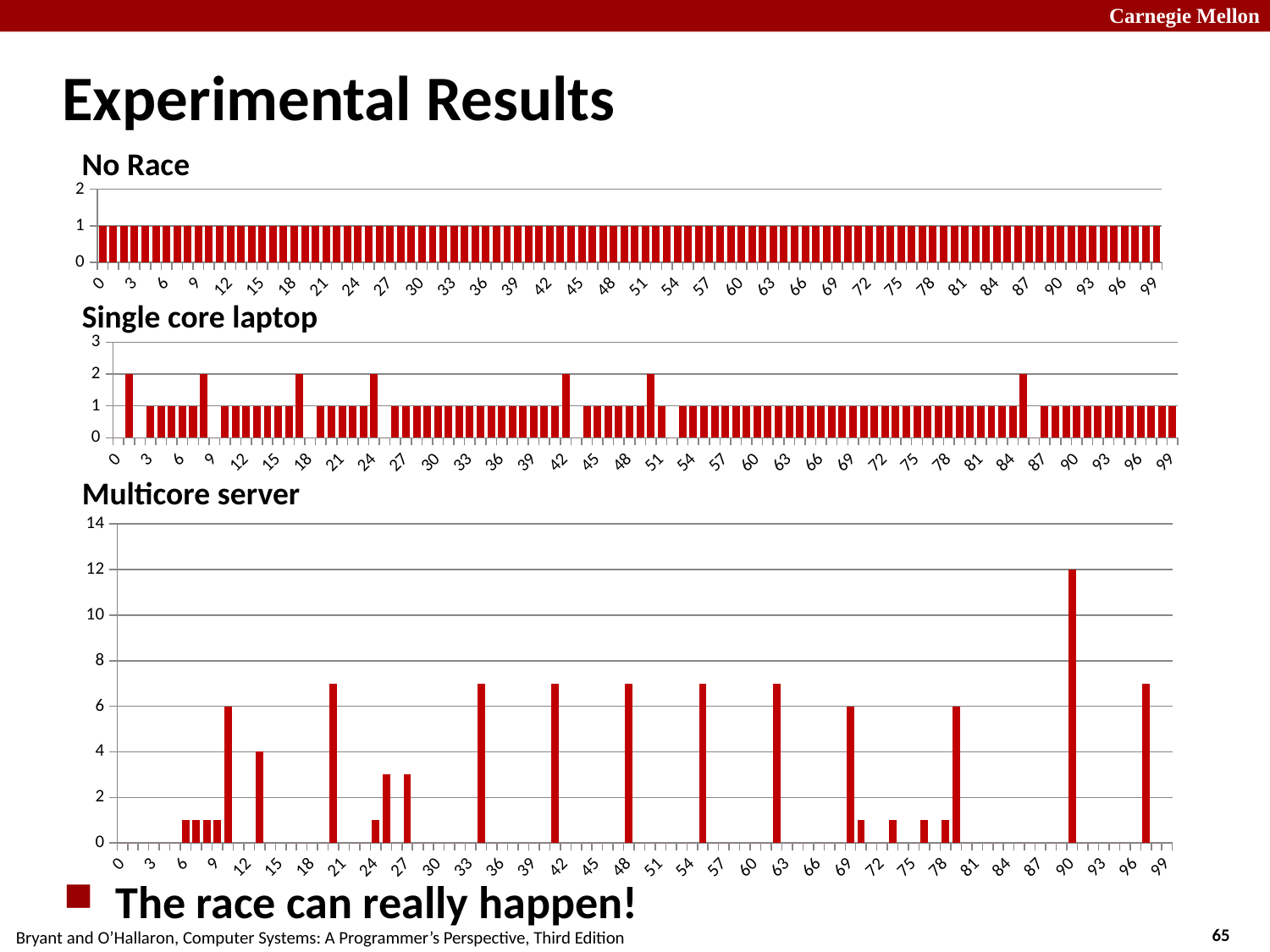
In the "Multicore server" chart, what is the value of the tallest bar? 12 What kind of chart is the "Multicore server" chart? bar chart In the "Multicore server" chart, is the value of the bar at x = 90 greater or less than 10? greater What is the title of the bottom chart on the slide? Multicore server What is the maximum value shown on the y axis of the "Multicore server" chart? 14 In the "No Race" chart, what value do all the bars have? 1 In the "Single core laptop" chart, what is the highest value reached by any bar? 2 In the "Multicore server" chart, which x-axis category has the highest bar? 90